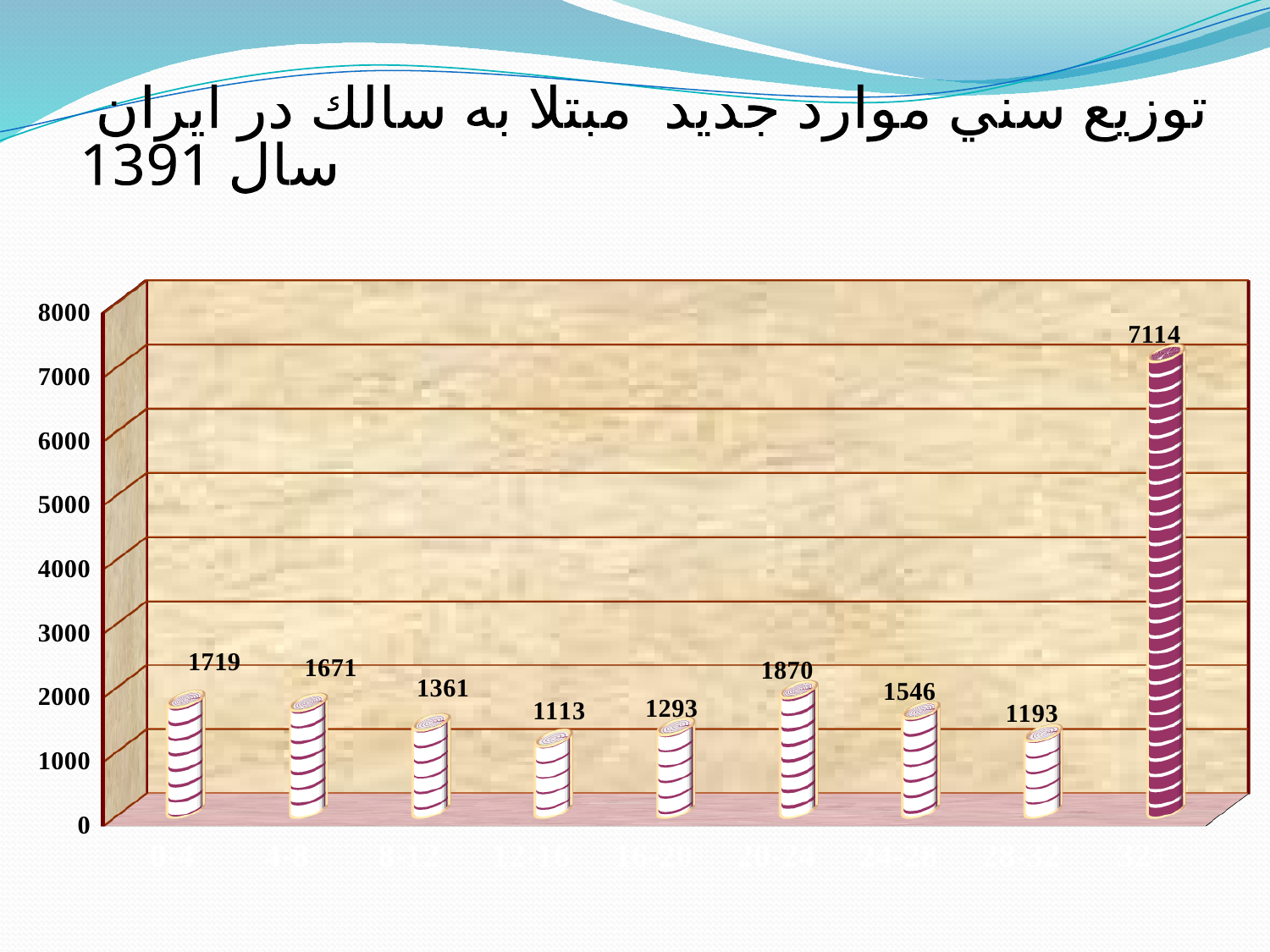
What is the value for the 20-24 age group? 1870 What is the difference between the value for 32+ and the value for 20-24? 5244 How many age groups (bars) are shown in the chart? 9 Which age group has the highest value? 32+ What is the highest value shown on the vertical axis? 8000 What kind of chart is shown on the slide? Bar chart What is the value of the first (leftmost) bar, labelled 0-4? 1719 What is the value of the last (rightmost) bar, labelled 32+? 7114 What is the difference between the values for 0-4 and 4-8? 48 Which age group has the lowest value? 12-16 Which is larger, the value for 24-28 or the value for 28-32? 24-28 What is the value for the 12-16 age group? 1113